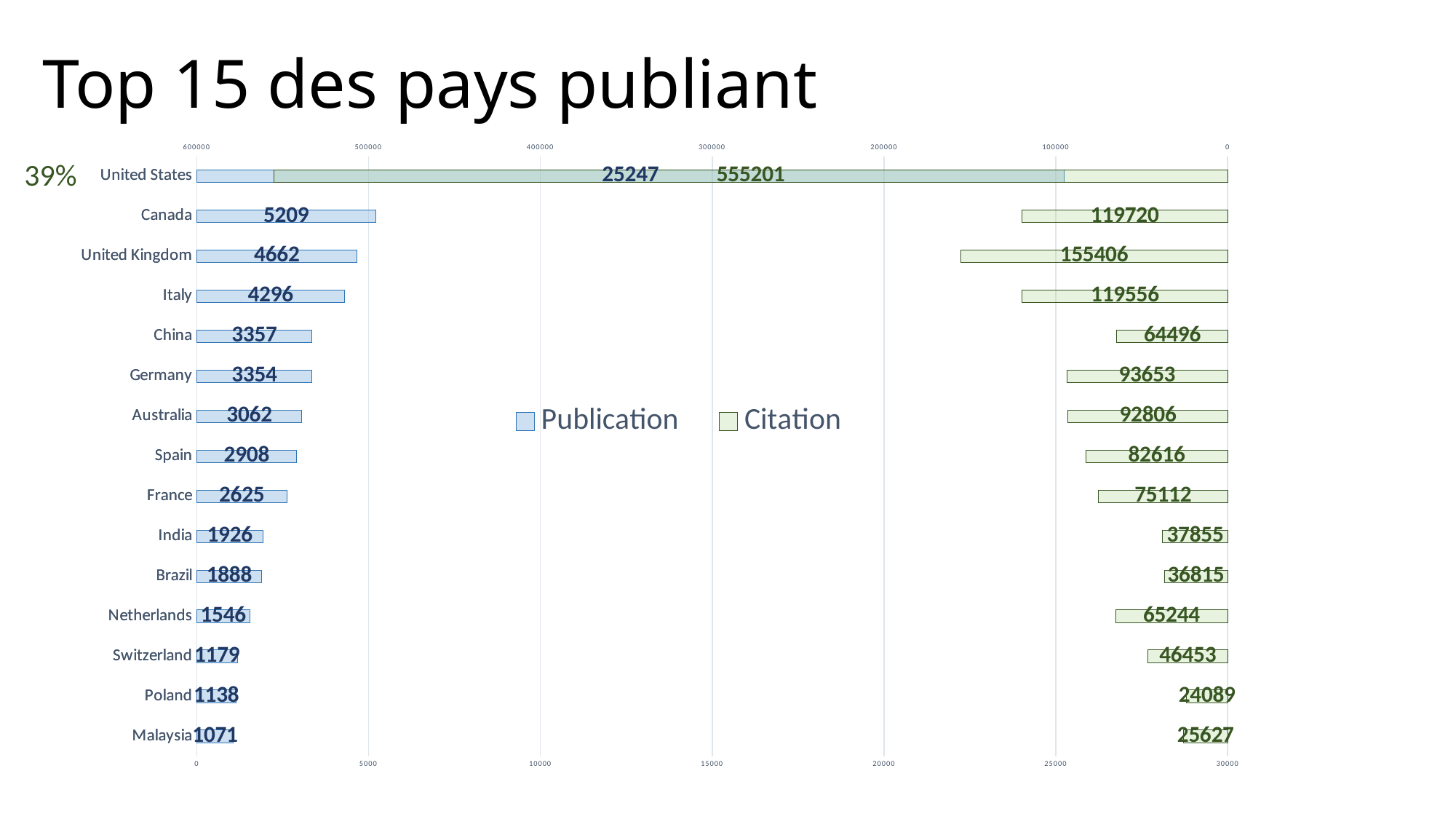
What type of chart is shown on the slide? Bar chart How many series does the legend list? 2 What is the Publication value for Canada? 5209 Which has a larger Publication value, China or Germany? China Which country has the lowest Publication value? Malaysia What is the Citation value for the United Kingdom? 155406 What is the difference between the Citation values of the United Kingdom and Canada? 35686 Which country has the lowest Citation value? Poland What is the Citation value for Germany? 93653 Which country has the highest Publication value? United States What is the difference between the Publication values of Canada and the United Kingdom? 547 How many countries are shown in the chart? 15